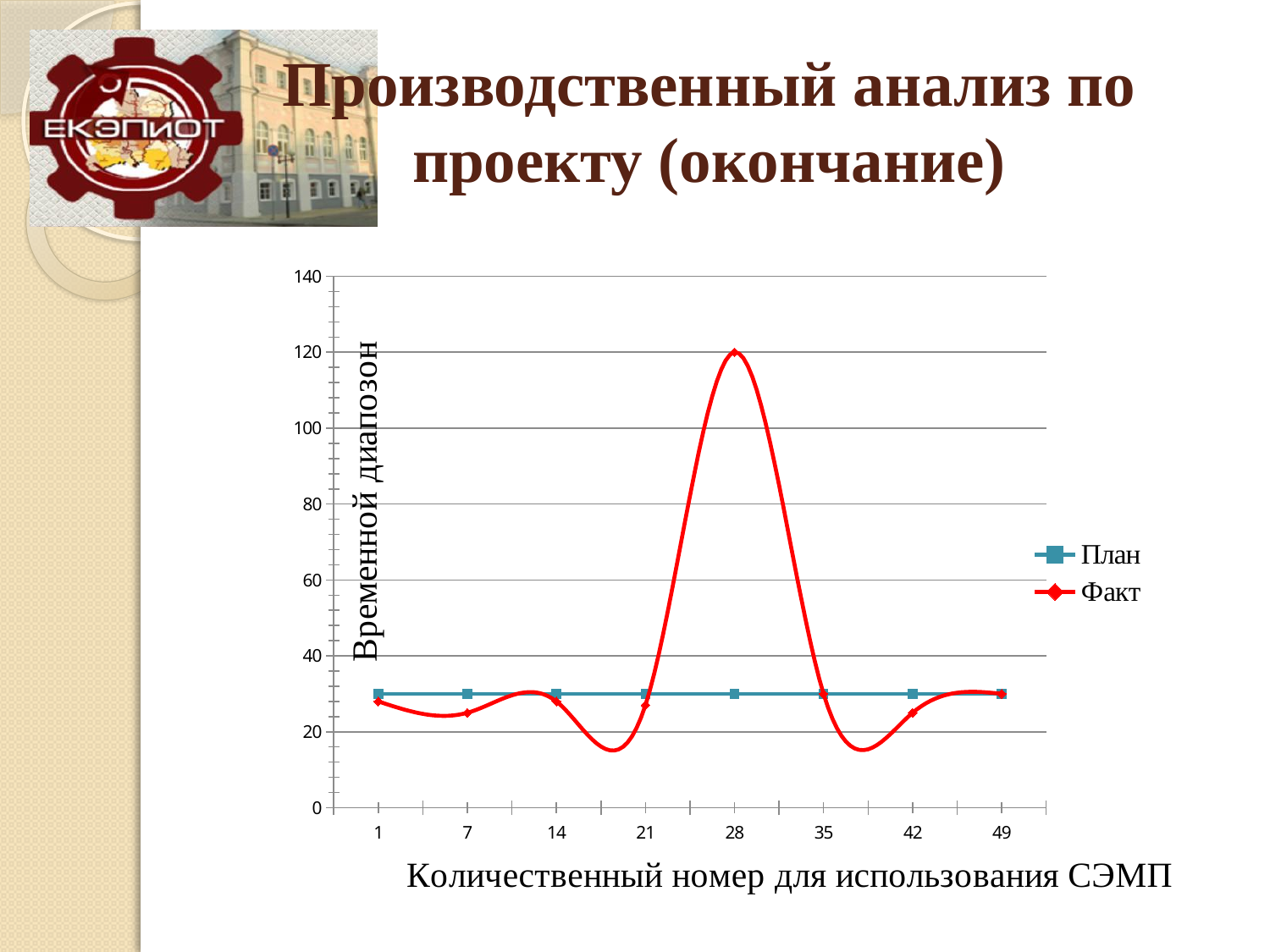
How many points are labelled along the x axis? 8 What is the title of the y axis? Временной диапозон Is the value of the План series at x = 14 greater or less than 40? less How many series does the legend list? 2 What is the value of the Факт series at x = 28? 120 Is the value of the Факт series at x = 28 greater or less than 100? greater At x = 28, which series has the larger value, План or Факт? Факт Which series are listed in the legend? План, Факт Is the value of the Факт series at x = 1 greater or less than 40? less At which x-axis value does the Факт series reach its highest point? 28 What kind of chart is shown on the slide? line chart Does the Факт series rise or fall between x = 28 and x = 35? fall